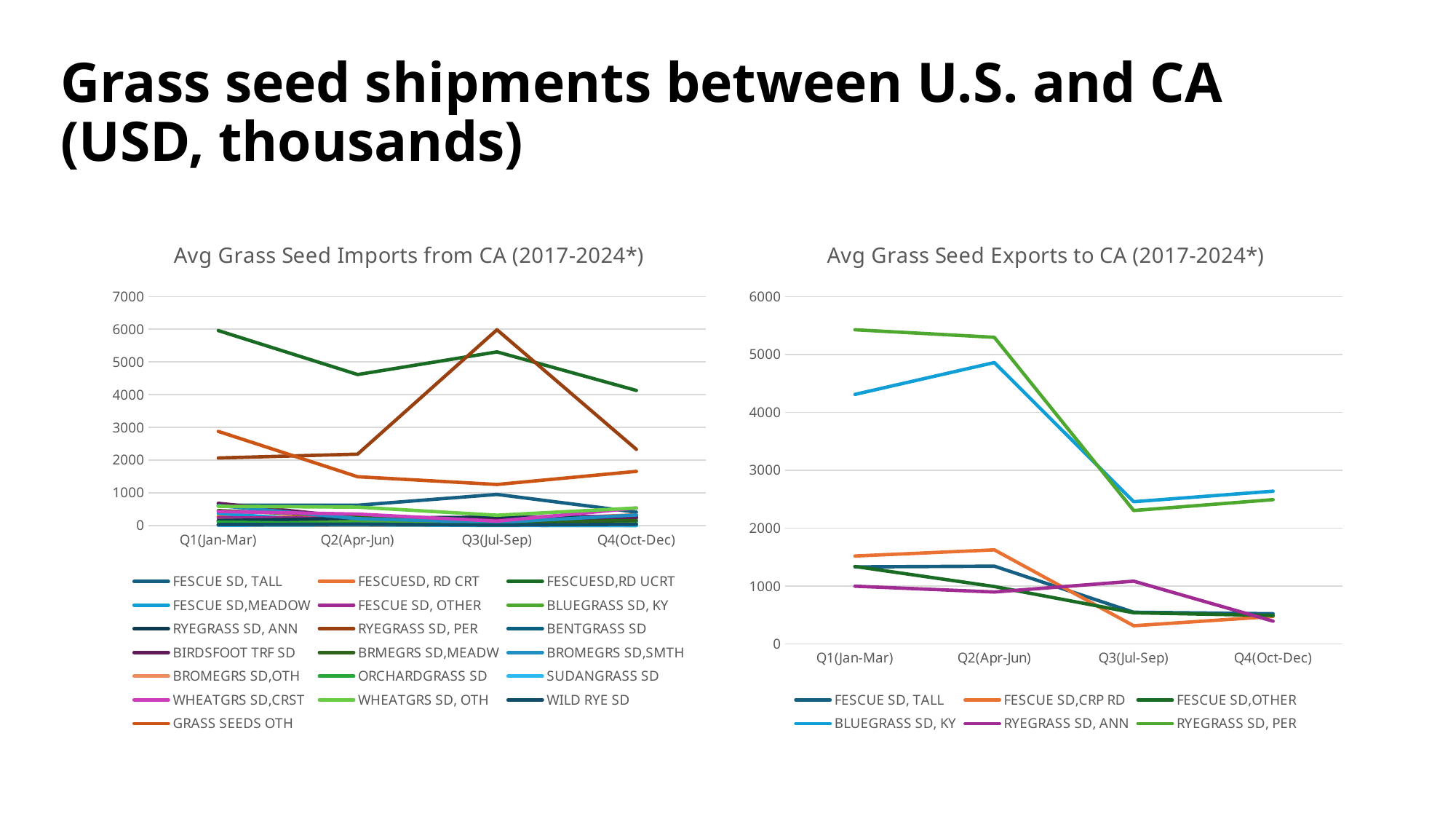
How many series does the legend of the 'Avg Grass Seed Exports to CA (2017-2024*)' chart list? 6 What kind of chart is the 'Avg Grass Seed Exports to CA (2017-2024*)' chart? line chart What is the title of the chart on the left side of the slide? Avg Grass Seed Imports from CA (2017-2024*) In the 'Avg Grass Seed Imports from CA (2017-2024*)' chart, which series has the highest value at Q1(Jan-Mar)? FESCUESD,RD UCRT In the 'Avg Grass Seed Exports to CA (2017-2024*)' chart, which is larger at Q2(Apr-Jun): BLUEGRASS SD, KY or RYEGRASS SD, PER? RYEGRASS SD, PER How many quarters are shown on the x axis of the 'Avg Grass Seed Exports to CA (2017-2024*)' chart? 4 In the 'Avg Grass Seed Exports to CA (2017-2024*)' chart, does the RYEGRASS SD, PER line rise or fall from Q1(Jan-Mar) to Q3(Jul-Sep)? fall In the 'Avg Grass Seed Imports from CA (2017-2024*)' chart, which series has the highest value at Q3(Jul-Sep)? RYEGRASS SD, PER In the 'Avg Grass Seed Exports to CA (2017-2024*)' chart, is the value for RYEGRASS SD, PER at Q1(Jan-Mar) greater or less than 5000? greater In the 'Avg Grass Seed Exports to CA (2017-2024*)' chart, which series has the highest value at Q1(Jan-Mar)? RYEGRASS SD, PER In the 'Avg Grass Seed Exports to CA (2017-2024*)' chart, is the value for BLUEGRASS SD, KY at Q1(Jan-Mar) greater or less than 5000? less In the 'Avg Grass Seed Imports from CA (2017-2024*)' chart, is the value for GRASS SEEDS OTH at Q1(Jan-Mar) greater or less than 2000? greater